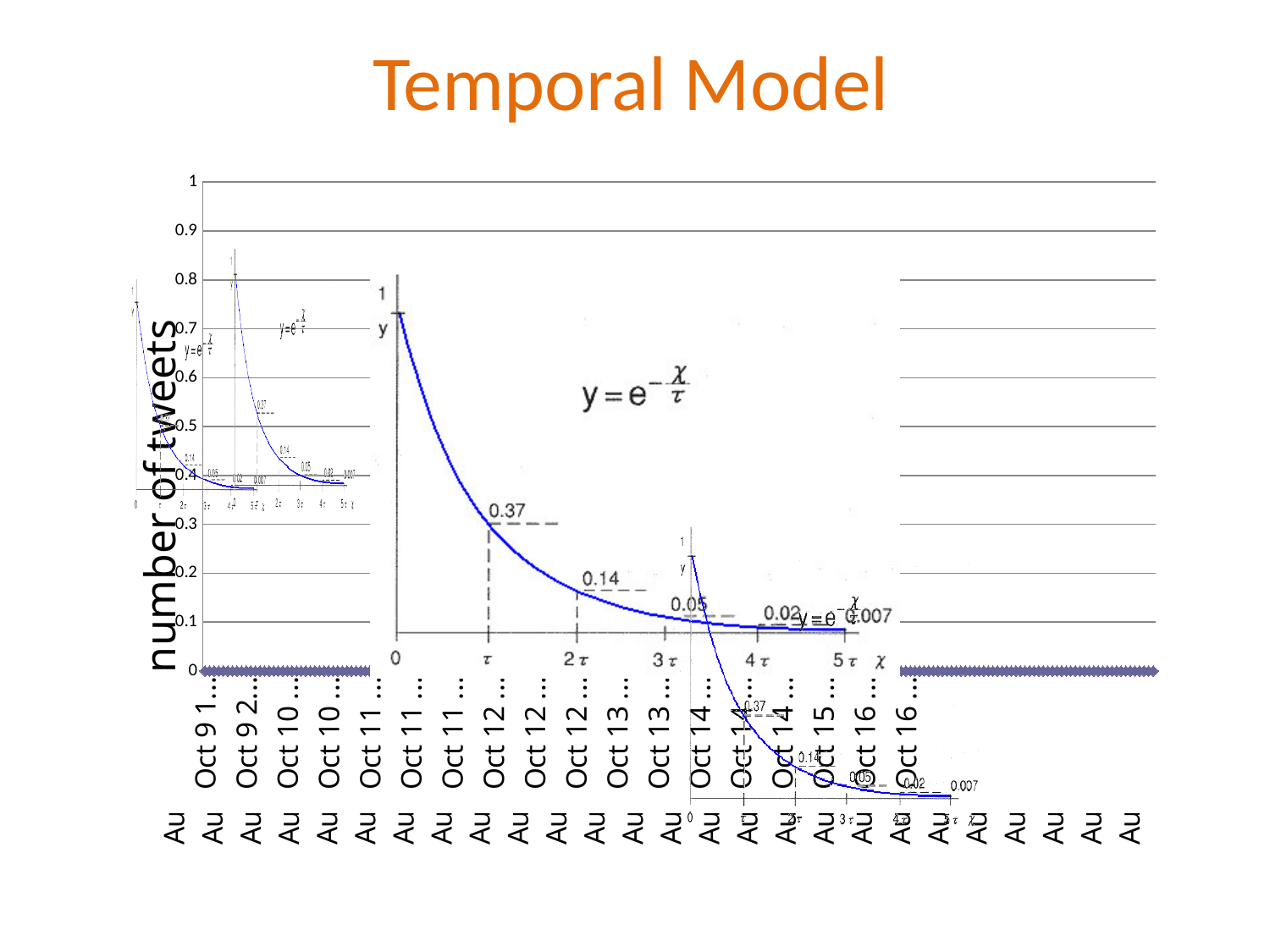
On the large decay curve, which is larger: the value at τ or the value at 3τ? the value at τ On the large decay curve, what is the value of y at χ = τ? 0.37 On the large decay curve, what is the value of y at χ = 2τ? 0.14 On the large decay curve, what is the value of y at χ = 4τ? 0.02 On the large decay curve, do the values rise or fall as χ increases? fall On the large decay curve, which labelled point has the highest value? τ What equation is written on the large decay curve overlaid on the chart? y = e^(-χ/τ) On the large decay curve, what is the value of y at χ = 3τ? 0.05 On the large decay curve, what is the value of y at χ = 5τ? 0.007 On the large decay curve, what is the difference between the value at τ and the value at 2τ? 0.23 On the large decay curve, which labelled point has the lowest value? 5τ What is the label on the vertical axis of the chart? number of tweets